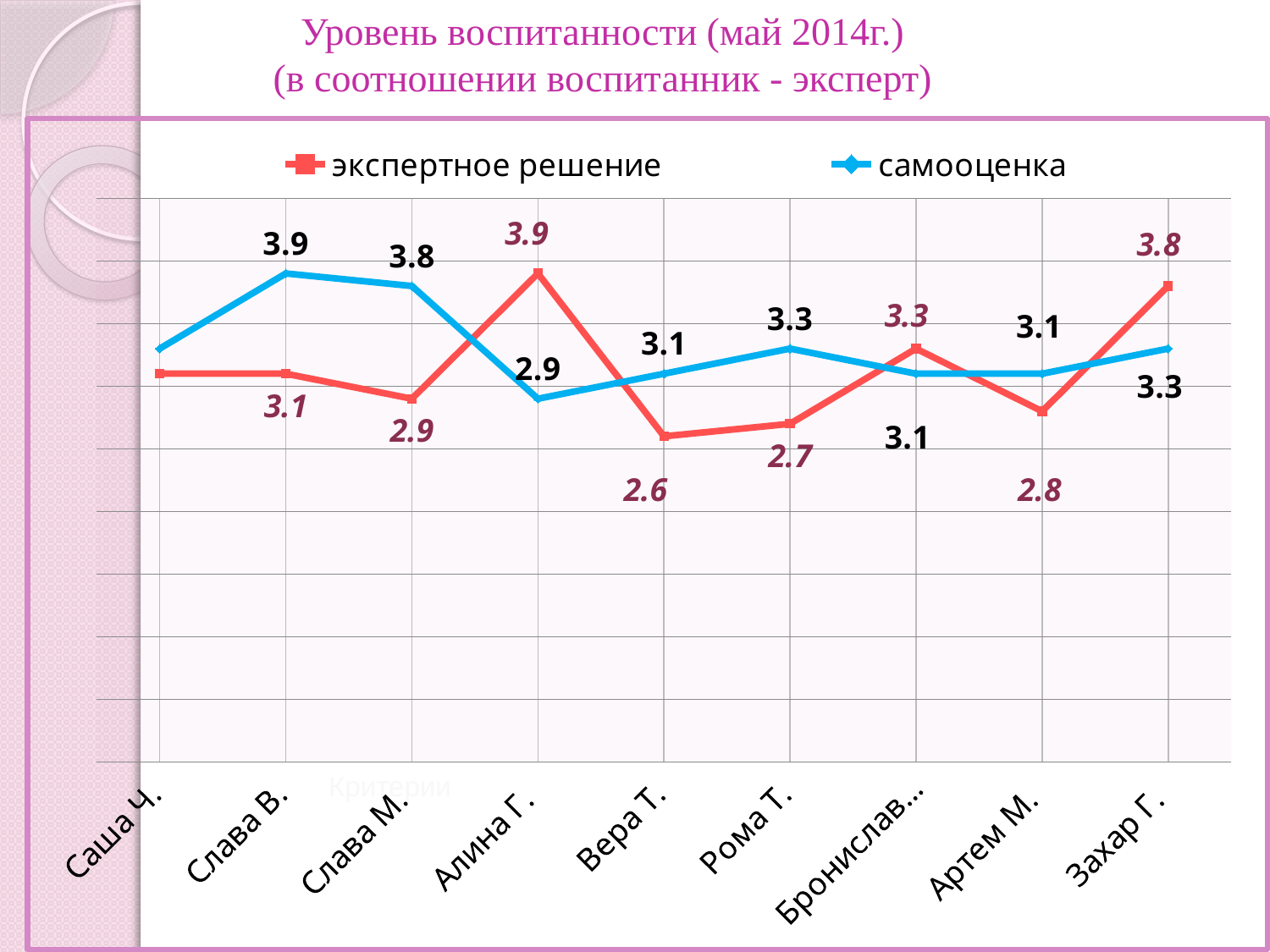
What kind of chart is shown on the slide? line chart Which person has the lowest экспертное решение value? Вера Т. What is the экспертное решение value for Захар Г.? 3.8 How many series does the legend list? 2 For Слава В., what is the difference between the самооценка and экспертное решение values? 0.8 What is the самооценка value for Алина Г.? 2.9 What is the экспертное решение value for Вера Т.? 2.6 What is the самооценка value for Слава В.? 3.9 Which person has the highest экспертное решение value? Алина Г. Which person has the highest самооценка value? Слава В. How many people are shown on the x axis? 9 For Алина Г., which is higher: самооценка or экспертное решение? экспертное решение